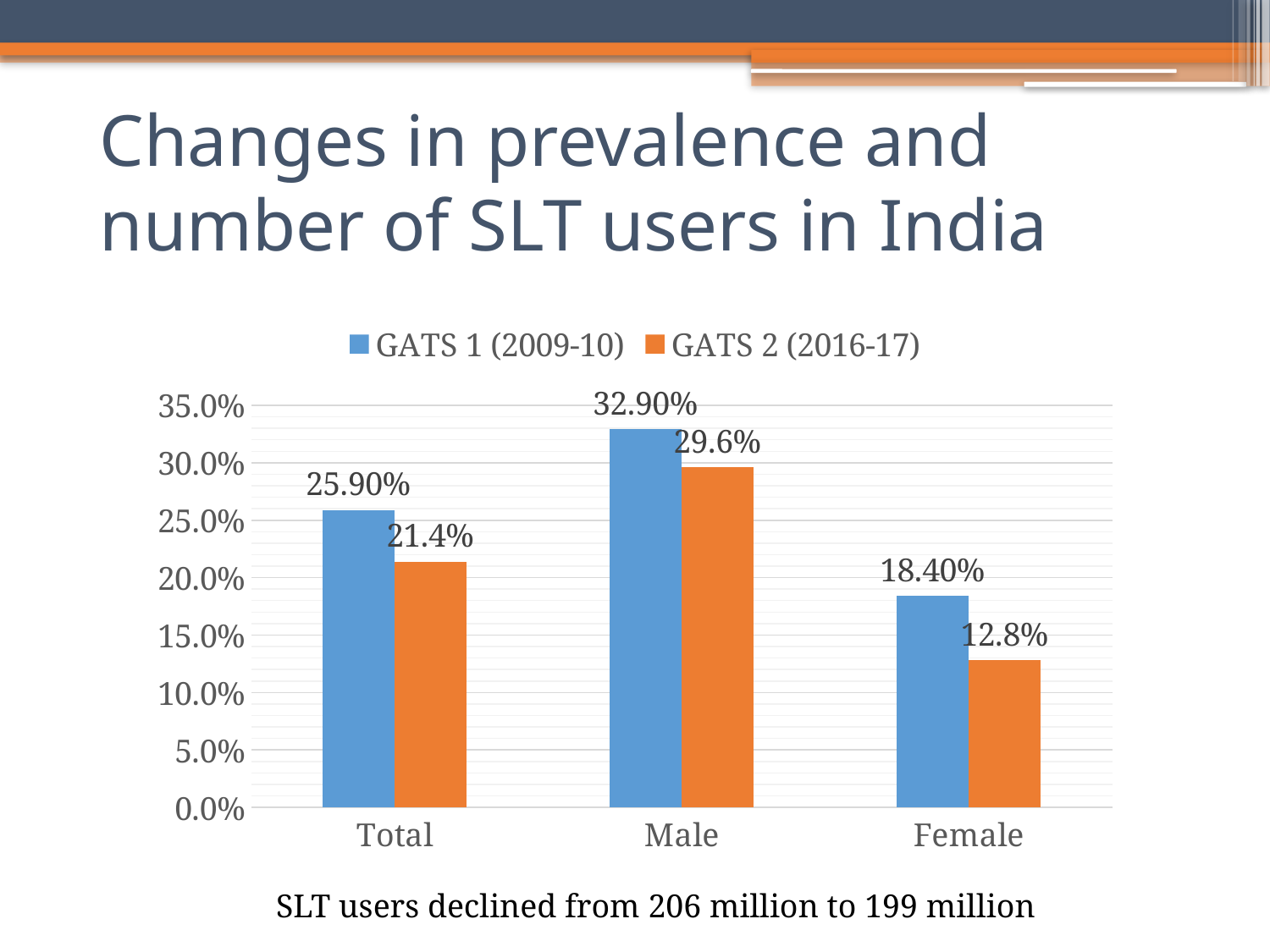
How many series does the legend list? 2 What is the difference between the GATS 1 (2009-10) and GATS 2 (2016-17) values for Female? 5.6% Which colour represents GATS 2 (2016-17) in the chart? Orange What kind of chart is shown on the slide? Bar chart Which category has the highest GATS 1 (2009-10) value? Male What is the GATS 2 (2016-17) value for Total? 21.4% What is the GATS 1 (2009-10) value for Male? 32.90% How many categories are shown on the x axis? 3 What is the GATS 2 (2016-17) value for Female? 12.8% Is the GATS 2 (2016-17) value for Male greater or less than 25.0%? greater Which category has the lowest GATS 2 (2016-17) value? Female Which is larger for Total: the GATS 1 (2009-10) value or the GATS 2 (2016-17) value? GATS 1 (2009-10)